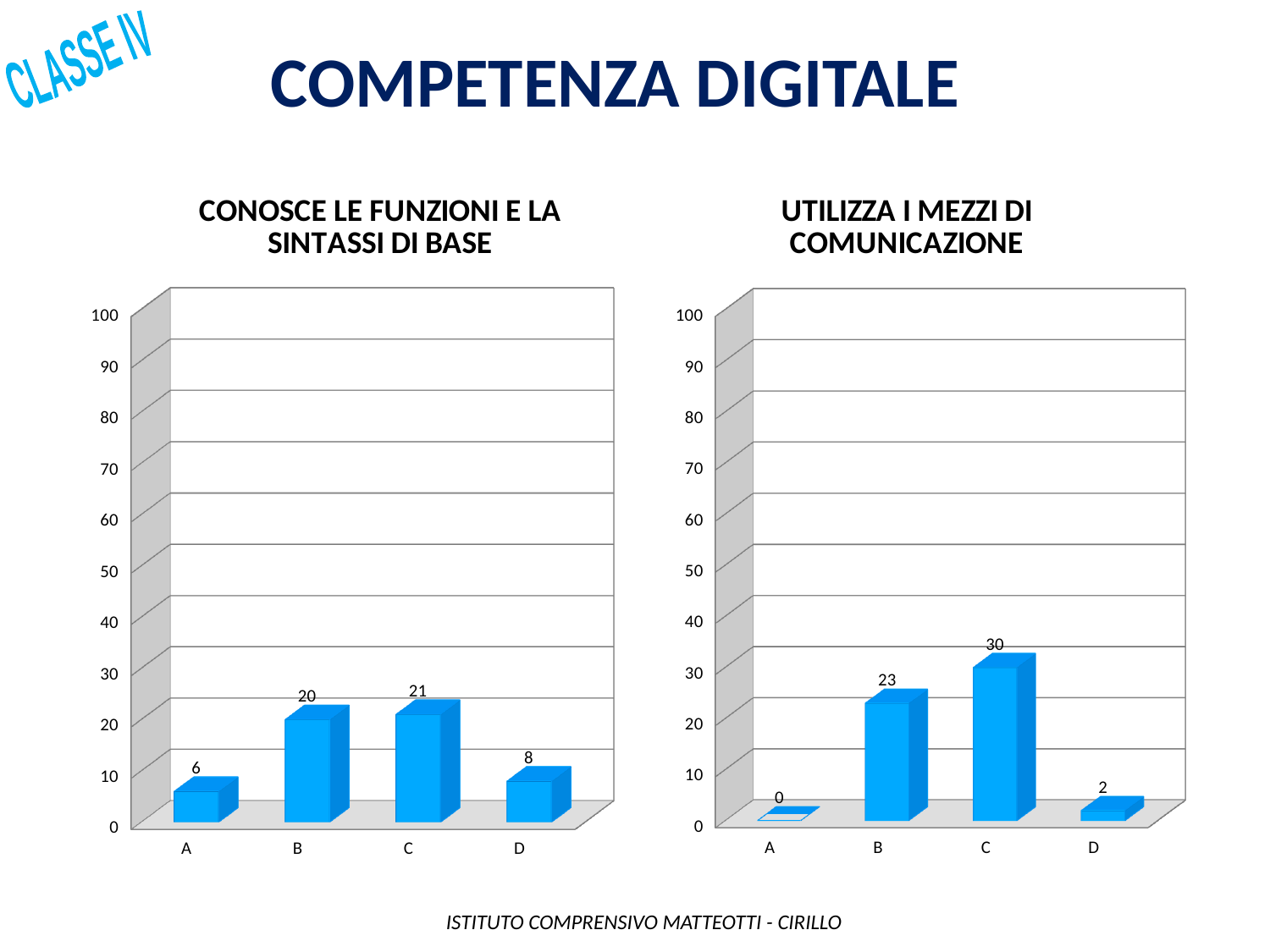
How many categories are shown in the chart titled "UTILIZZA I MEZZI DI COMUNICAZIONE"? 4 In the chart titled "UTILIZZA I MEZZI DI COMUNICAZIONE", which is larger, the value for B or the value for D? B In the chart titled "CONOSCE LE FUNZIONI E LA SINTASSI DI BASE", what is the value for category B? 20 In the chart titled "CONOSCE LE FUNZIONI E LA SINTASSI DI BASE", which category has the highest value? C In the chart titled "UTILIZZA I MEZZI DI COMUNICAZIONE", what is the value for category C? 30 What is the title of the chart on the right side of the slide? UTILIZZA I MEZZI DI COMUNICAZIONE In the chart titled "UTILIZZA I MEZZI DI COMUNICAZIONE", which category has the lowest value? A What kind of chart is the chart titled "CONOSCE LE FUNZIONI E LA SINTASSI DI BASE"? bar chart In the chart titled "CONOSCE LE FUNZIONI E LA SINTASSI DI BASE", is the value for B greater or less than 30? less In the chart titled "UTILIZZA I MEZZI DI COMUNICAZIONE", what is the difference between the values for C and B? 7 In the chart titled "CONOSCE LE FUNZIONI E LA SINTASSI DI BASE", what is the difference between the values for C and A? 15 In the chart titled "UTILIZZA I MEZZI DI COMUNICAZIONE", what is the value for category A? 0